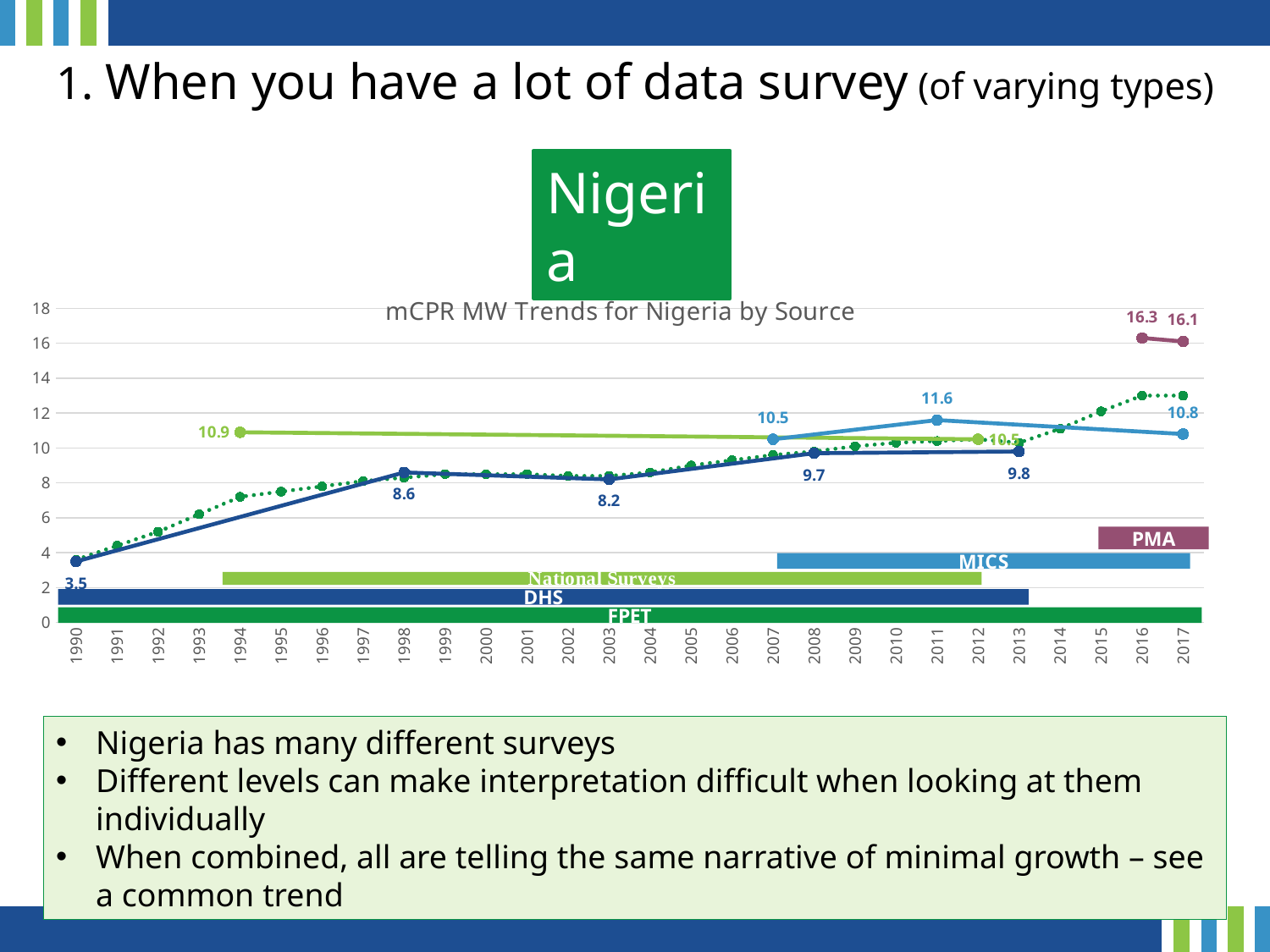
Which source shows the highest labelled value on the chart? PMA What is the difference between the DHS values for 2013 and 1990? 6.3 What is the title of the chart? mCPR MW Trends for Nigeria by Source What is the DHS value for 1990? 3.5 What is the DHS value for 2003? 8.2 Which is larger, the MICS value for 2011 or the DHS value for 2013? MICS value for 2011 What is the National Surveys value for 1994? 10.9 Is the PMA value for 2017 greater or less than 14? greater What is the DHS value for 1998? 8.6 What is the MICS value for 2011? 11.6 What is the PMA value for 2016? 16.3 What type of chart is shown on the slide? line chart